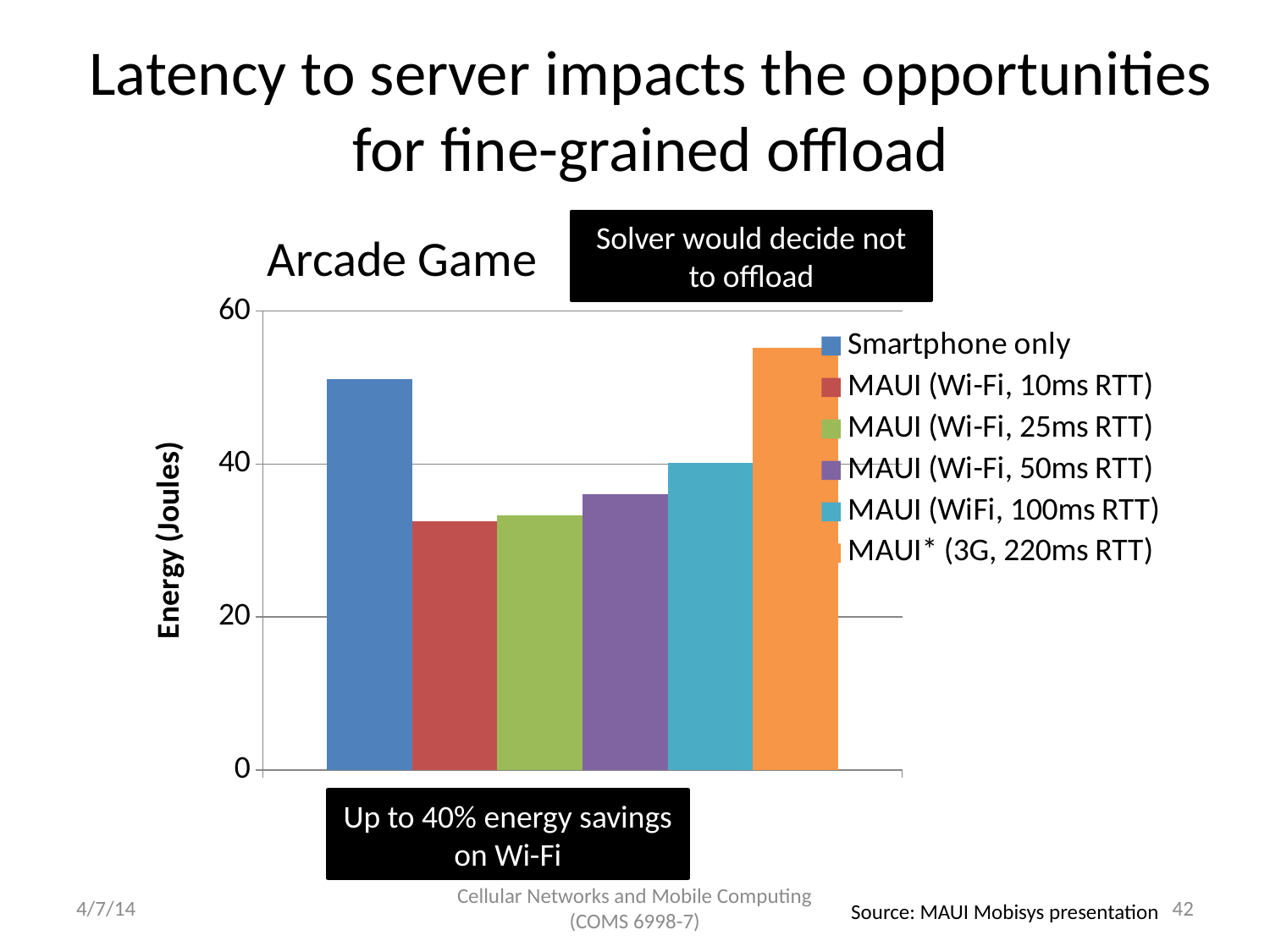
Is the value for MAUI (Wi-Fi, 50ms RTT) greater or less than 40? less Which series has the highest energy value? MAUI* (3G, 220ms RTT) What is the label on the vertical axis of the chart? Energy (Joules) How many bars are plotted in the chart? 6 What kind of chart is shown on the slide? bar chart Which is larger, the value for MAUI (WiFi, 100ms RTT) or the value for MAUI (Wi-Fi, 25ms RTT)? MAUI (WiFi, 100ms RTT) Is the value for MAUI (Wi-Fi, 10ms RTT) greater or less than 40? less Across the MAUI Wi-Fi bars, does energy rise or fall as the RTT increases? rise Which is larger, the value for Smartphone only or the value for MAUI (Wi-Fi, 10ms RTT)? Smartphone only Is the value for MAUI* (3G, 220ms RTT) greater or less than 40? greater How many series does the legend list? 6